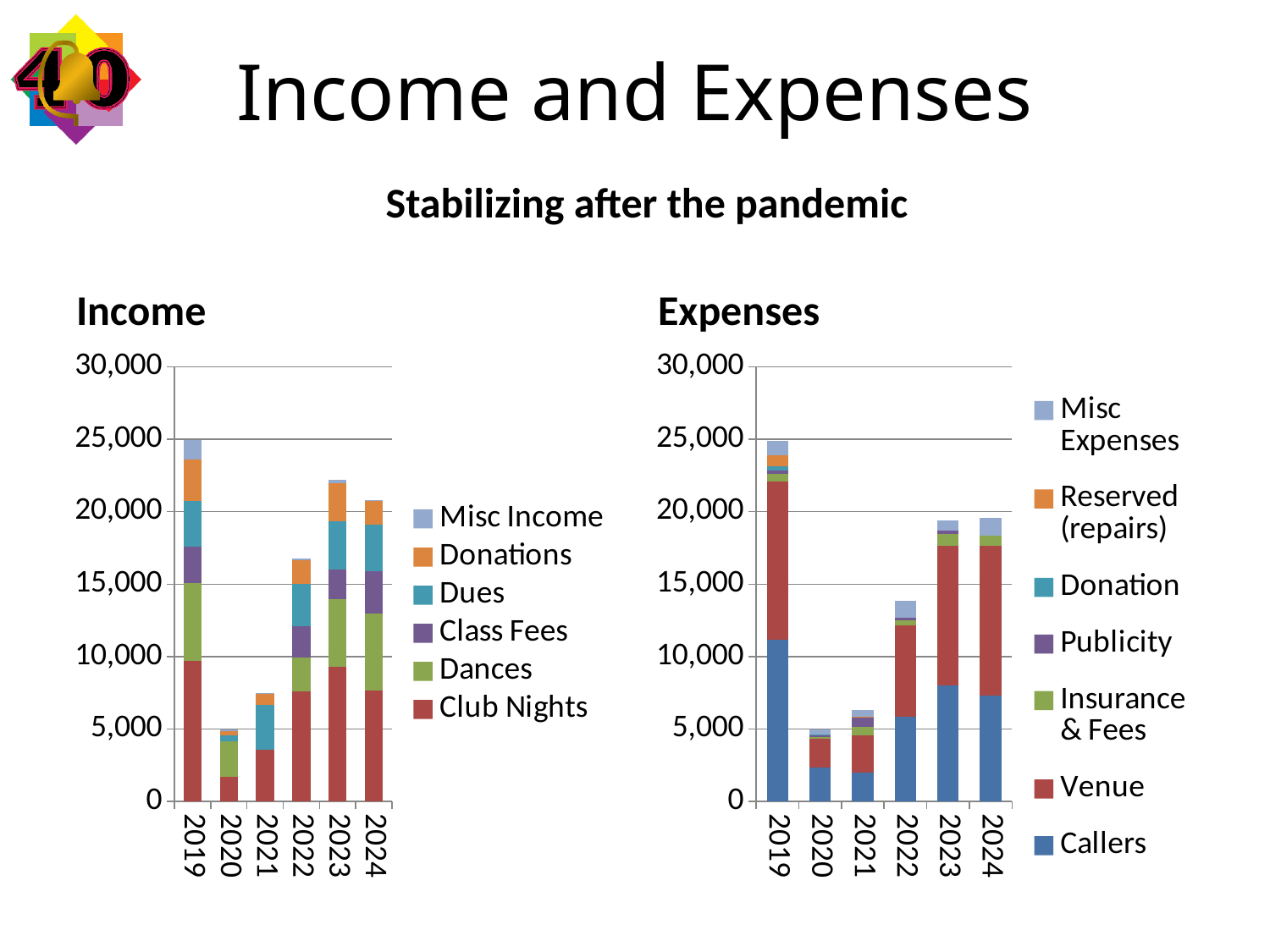
In the Income chart, which year has the highest total income? 2019 In the Income chart, is the total income for 2019 greater or less than 20,000? greater How many series does the legend of the Income chart list? 6 In the Income chart, which year has the larger total income, 2022 or 2023? 2023 In the Expenses chart, which year has the lowest total expenses? 2020 In the Expenses chart, which series is shown at the bottom of each stacked bar? Callers How many years are shown on the x axis of the Expenses chart? 6 How many series does the legend of the Expenses chart list? 7 What kind of chart is the Income chart? stacked bar chart In the Expenses chart, which year has the larger total expenses, 2019 or 2024? 2019 In the Expenses chart, is the total expenses for 2023 greater or less than 20,000? less In the Income chart, which year has the lowest total income? 2020